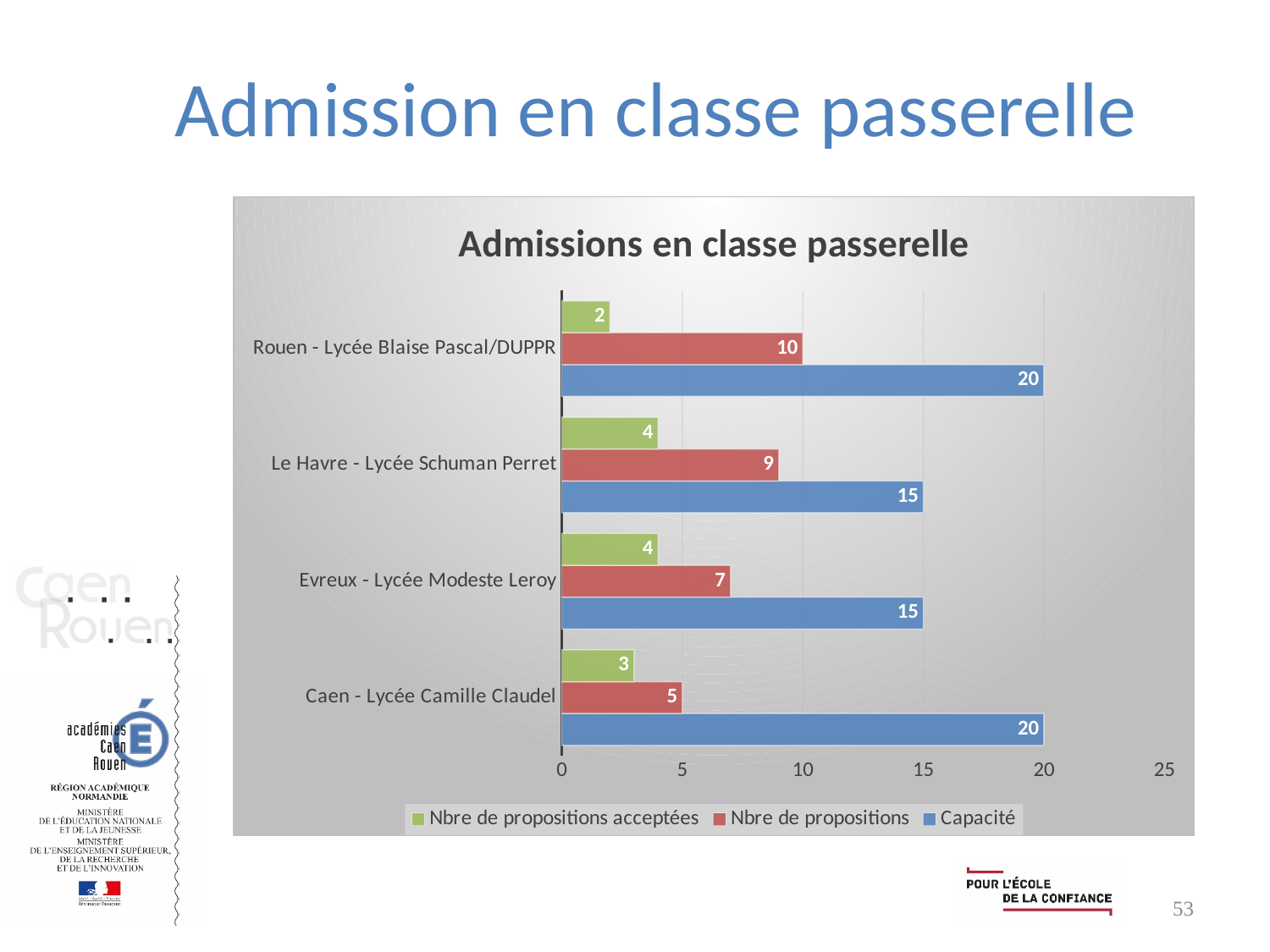
What is the Nbre de propositions acceptées value for Caen - Lycée Camille Claudel? 3 What is the Capacité value for Rouen - Lycée Blaise Pascal/DUPPR? 20 Which is larger for Le Havre - Lycée Schuman Perret: Nbre de propositions or Nbre de propositions acceptées? Nbre de propositions What is the title of the chart? Admissions en classe passerelle How many categories (lycées) are shown on the chart? 4 Which category has the lowest Nbre de propositions? Caen - Lycée Camille Claudel Is the Capacité value for Le Havre - Lycée Schuman Perret greater or less than 10? greater What kind of chart is shown on the slide? Bar chart What is the difference between Capacité and Nbre de propositions for Evreux - Lycée Modeste Leroy? 8 What is the Nbre de propositions value for Le Havre - Lycée Schuman Perret? 9 Which category has the highest Nbre de propositions? Rouen - Lycée Blaise Pascal/DUPPR How many series does the legend list? 3